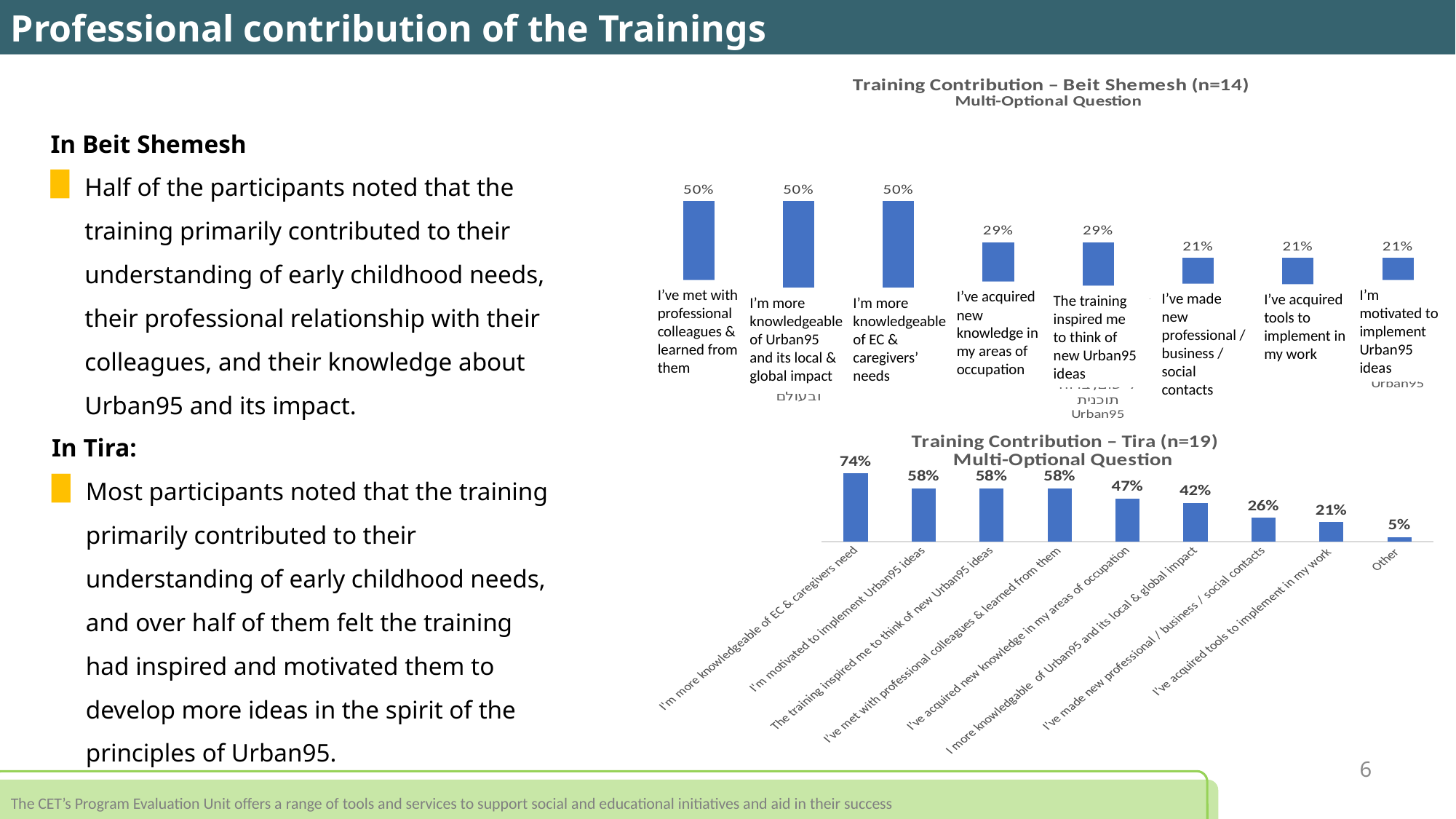
In the Training Contribution – Tira chart, what is the value for "I've acquired new knowledge in my areas of occupation"? 47% In the Training Contribution – Beit Shemesh chart, what is the value for "I've acquired new knowledge in my areas of occupation"? 29% In the Training Contribution – Tira chart, do the values rise or fall from left to right? Fall In the Training Contribution – Beit Shemesh chart, which is larger: "I've met with professional colleagues & learned from them" or "I've made new professional / business / social contacts"? I've met with professional colleagues & learned from them In the Training Contribution – Tira chart, how many categories are plotted? 9 In the Training Contribution – Tira chart, what is the difference between "I'm more knowledgeable of EC & caregivers need" and "I've acquired tools to implement in my work"? 53% In the Training Contribution – Beit Shemesh chart, how many categories are plotted? 8 In the Training Contribution – Tira chart, which category has the highest value? I'm more knowledgeable of EC & caregivers need In the Training Contribution – Tira chart, which category has the lowest value? Other In the Training Contribution – Tira chart, what percentage is shown for "I'm more knowledgeable of EC & caregivers need"? 74% In the Training Contribution – Beit Shemesh chart, what is the value for "I've acquired tools to implement in my work"? 21% What kind of chart is the Training Contribution – Tira chart? Bar chart